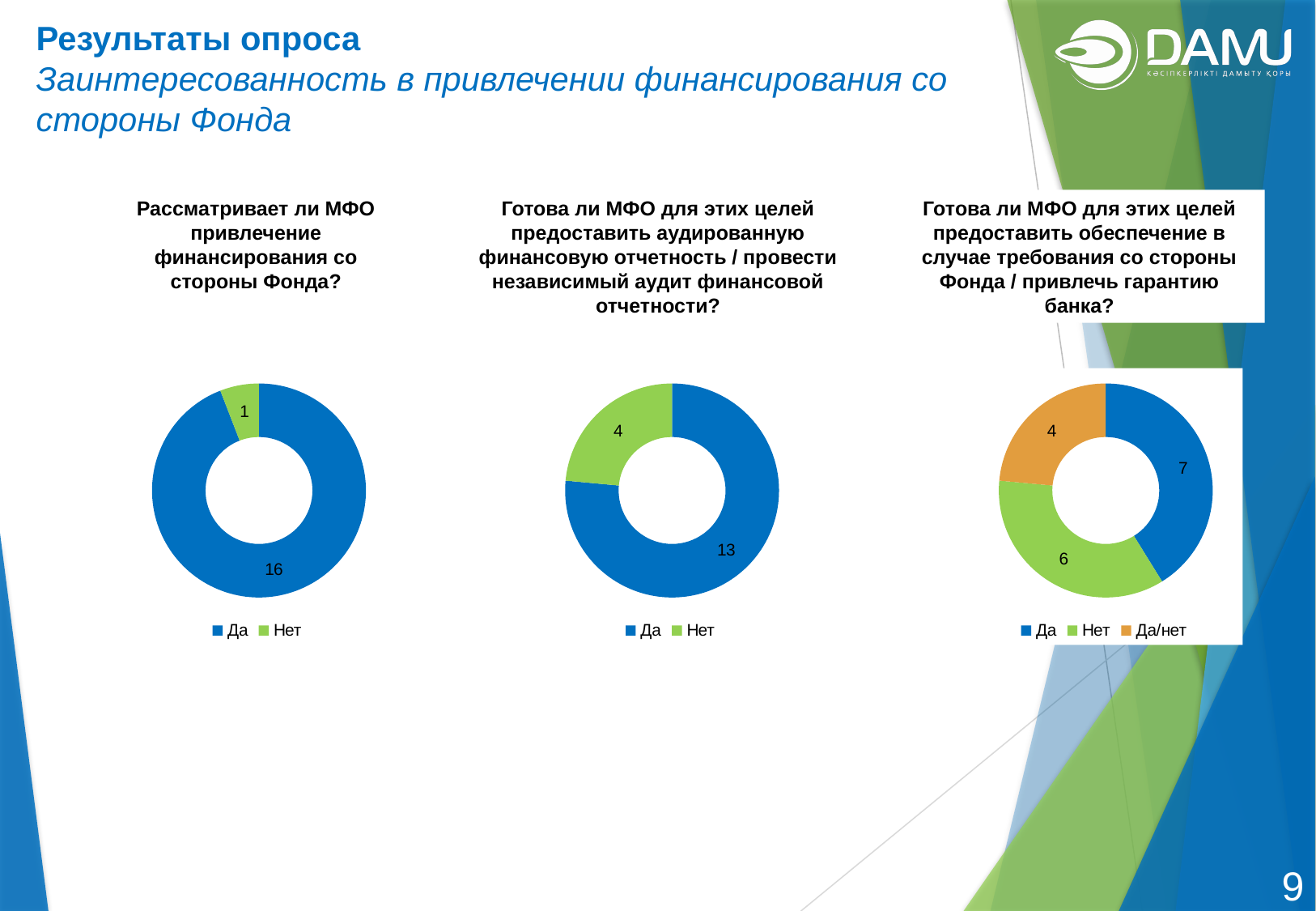
In the middle chart, what is the value for "Да"? 13 In the left chart, which is larger, "Да" or "Нет"? Да In the left chart ("Рассматривает ли МФО привлечение финансирования со стороны Фонда?"), what is the value for "Да"? 16 In the right chart, which category has the lowest value? Да/нет In the middle chart, what is the difference between the values for "Да" and "Нет"? 9 What type of chart is the left chart? Doughnut chart In the right chart, what is the total of all slices? 17 How many series does the legend of the right chart list? 3 In the right chart, which category has the highest value? Да In the right chart (about providing collateral / bank guarantee), what is the value for "Да/нет"? 4 In the left chart, what is the value for "Нет"? 1 In the middle chart (about providing audited financial statements), what is the value for "Нет"? 4